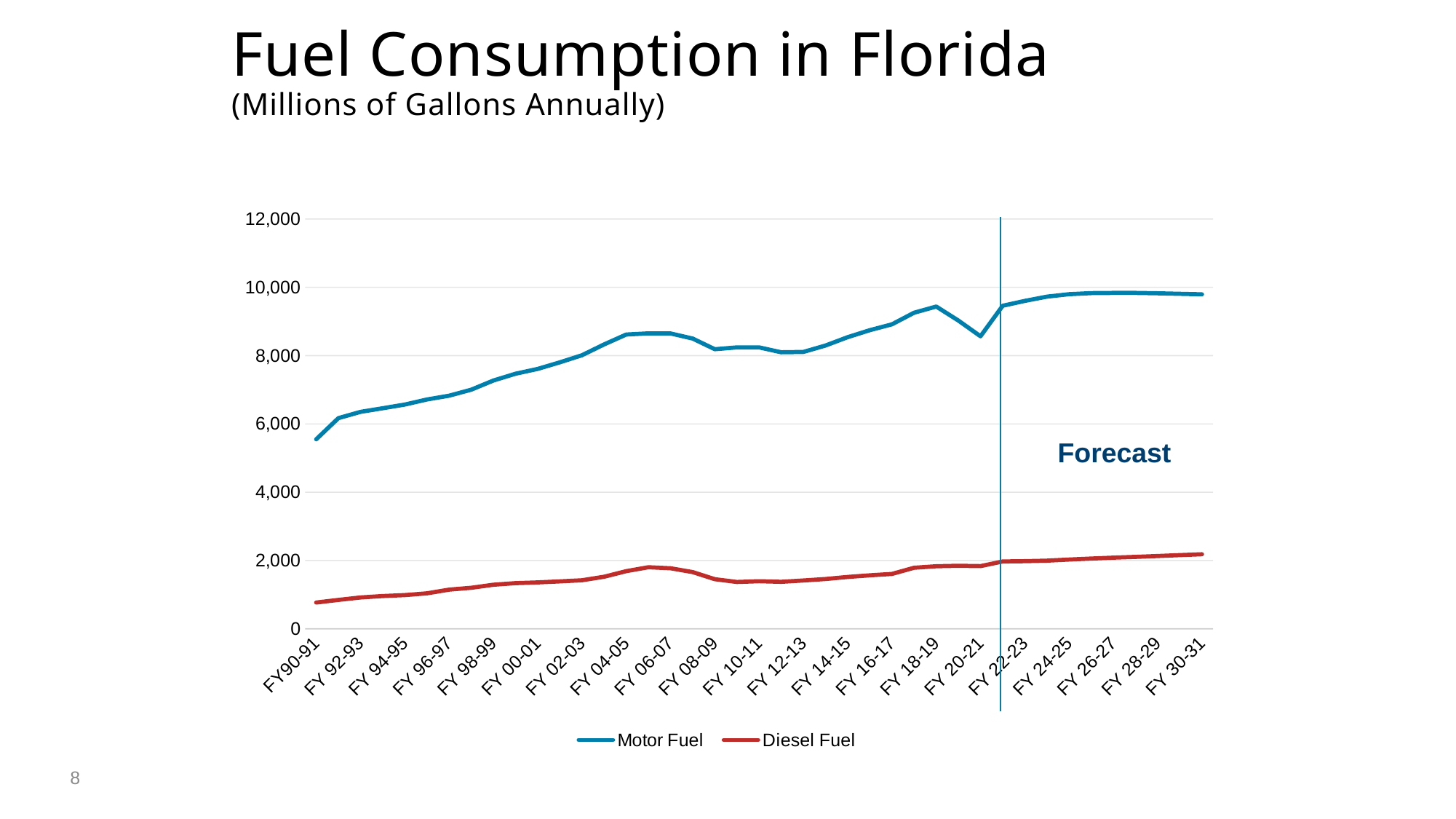
How many series does the legend list? 2 Is the Motor Fuel value for FY90-91 greater or less than 6,000? less Is the Motor Fuel value for FY 04-05 greater or less than 8,000? greater Does the Diesel Fuel series generally rise or fall from FY90-91 to FY 30-31? rise Does the Motor Fuel series generally rise or fall from FY90-91 to FY 04-05? rise Is the Diesel Fuel value for FY 30-31 greater or less than 2,000? greater What is the title of the chart on the slide? Fuel Consumption in Florida (Millions of Gallons Annually) What kind of chart is shown on the slide? line chart Which series has the larger value in FY 18-19, Motor Fuel or Diesel Fuel? Motor Fuel Which two series are listed in the legend? Motor Fuel and Diesel Fuel